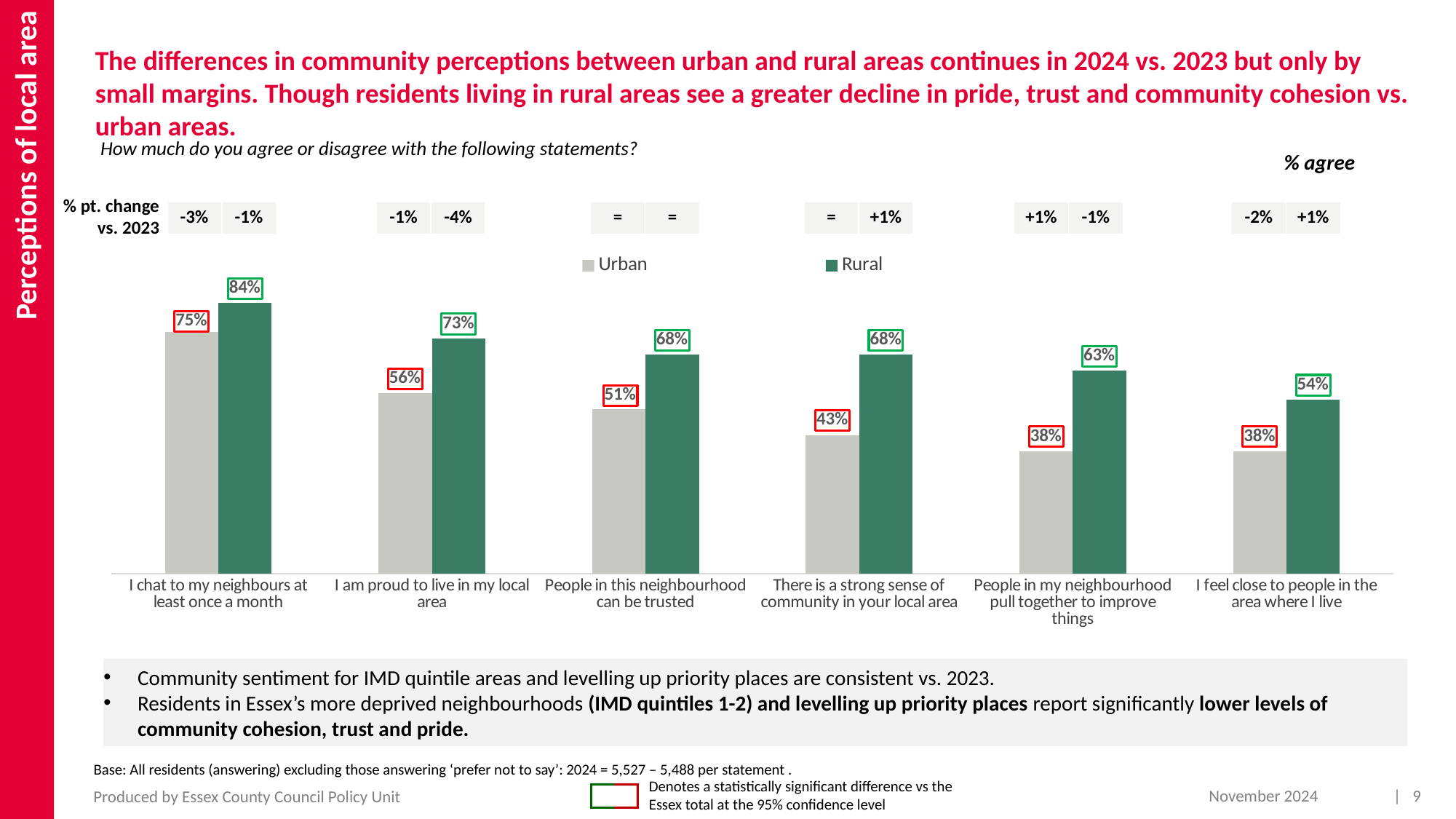
What is the difference between the Rural and Urban values for "People in my neighbourhood pull together to improve things"? 25% What is the Urban value for "I chat to my neighbours at least once a month"? 75% Which statement has the highest Rural value? I chat to my neighbours at least once a month What is the Urban value for "There is a strong sense of community in your local area"? 43% How many series does the chart legend list? 2 Which statement has the lowest Rural value? I feel close to people in the area where I live What are the two series named in the chart legend? Urban and Rural How many statements (categories) are shown on the x axis of the chart? 6 Which is larger for "People in this neighbourhood can be trusted": the Urban value or the Rural value? Rural What kind of chart is shown on the slide? Bar chart What is the Rural value for "I feel close to people in the area where I live"? 54% What is the Rural value for "I am proud to live in my local area"? 73%